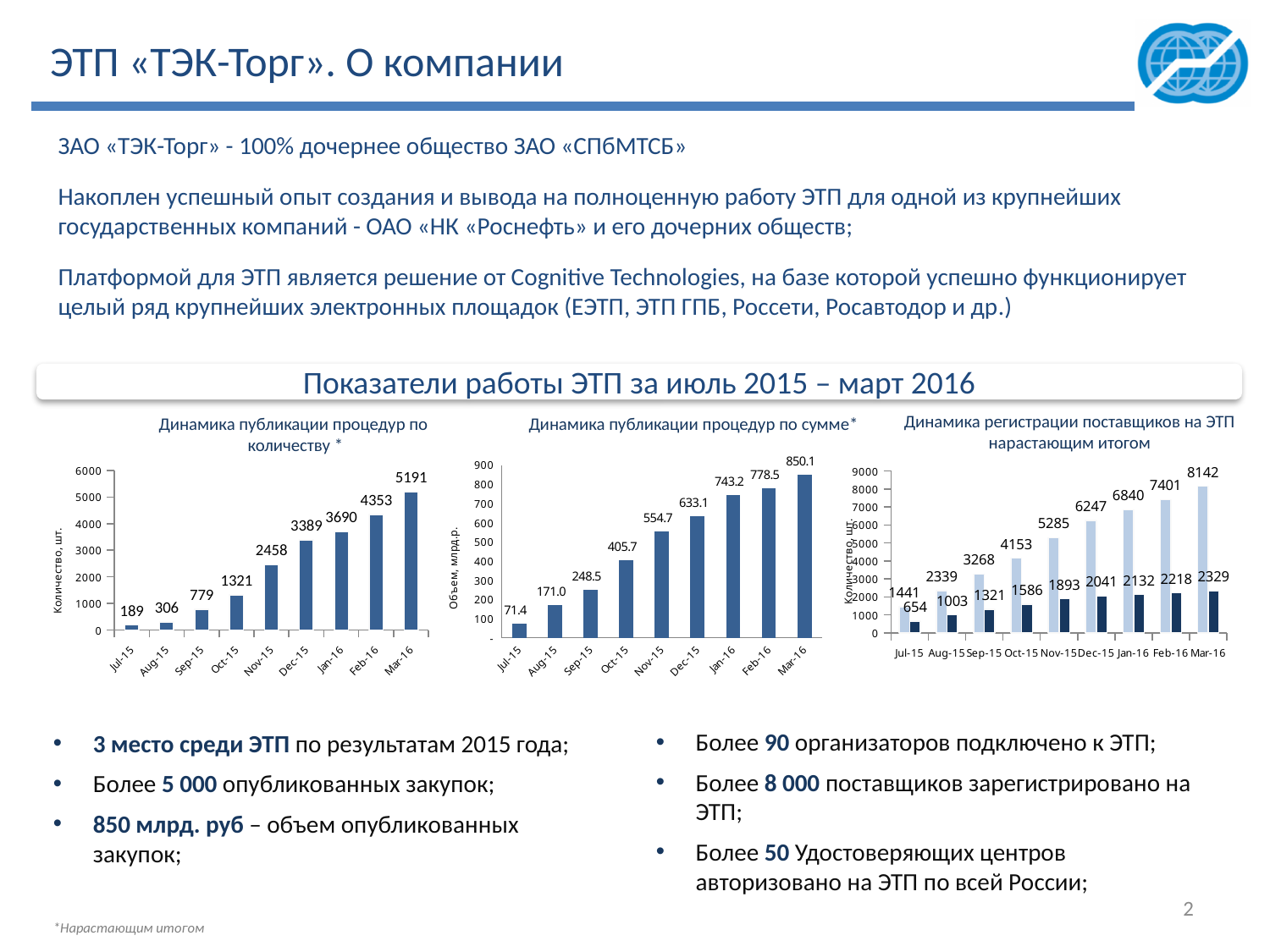
In the chart 'Динамика публикации процедур по количеству', what is the difference between the values for Feb-16 and Jan-16? 663 In the chart 'Динамика публикации процедур по сумме', what is the label of the vertical axis? Объем, млрд.р. In the chart 'Динамика публикации процедур по количеству', which month has the lowest value? Jul-15 In the chart 'Динамика публикации процедур по сумме', which month has the highest value? Mar-16 In the chart 'Динамика регистрации поставщиков на ЭТП нарастающим итогом', what is the value of the light blue bar for Mar-16? 8142 In the chart 'Динамика публикации процедур по количеству', how many months are plotted? 9 In the chart 'Динамика публикации процедур по сумме', do the values rise or fall from Jul-15 to Mar-16? rise In the chart 'Динамика публикации процедур по количеству', what is the value for Nov-15? 2458 In the chart 'Динамика регистрации поставщиков на ЭТП нарастающим итогом', what is the value of the dark blue bar for Jul-15? 654 In the chart 'Динамика публикации процедур по количеству', what is the value for Mar-16? 5191 What type of chart is 'Динамика регистрации поставщиков на ЭТП нарастающим итогом'? bar chart In the chart 'Динамика публикации процедур по сумме', what is the value for Oct-15? 405.7